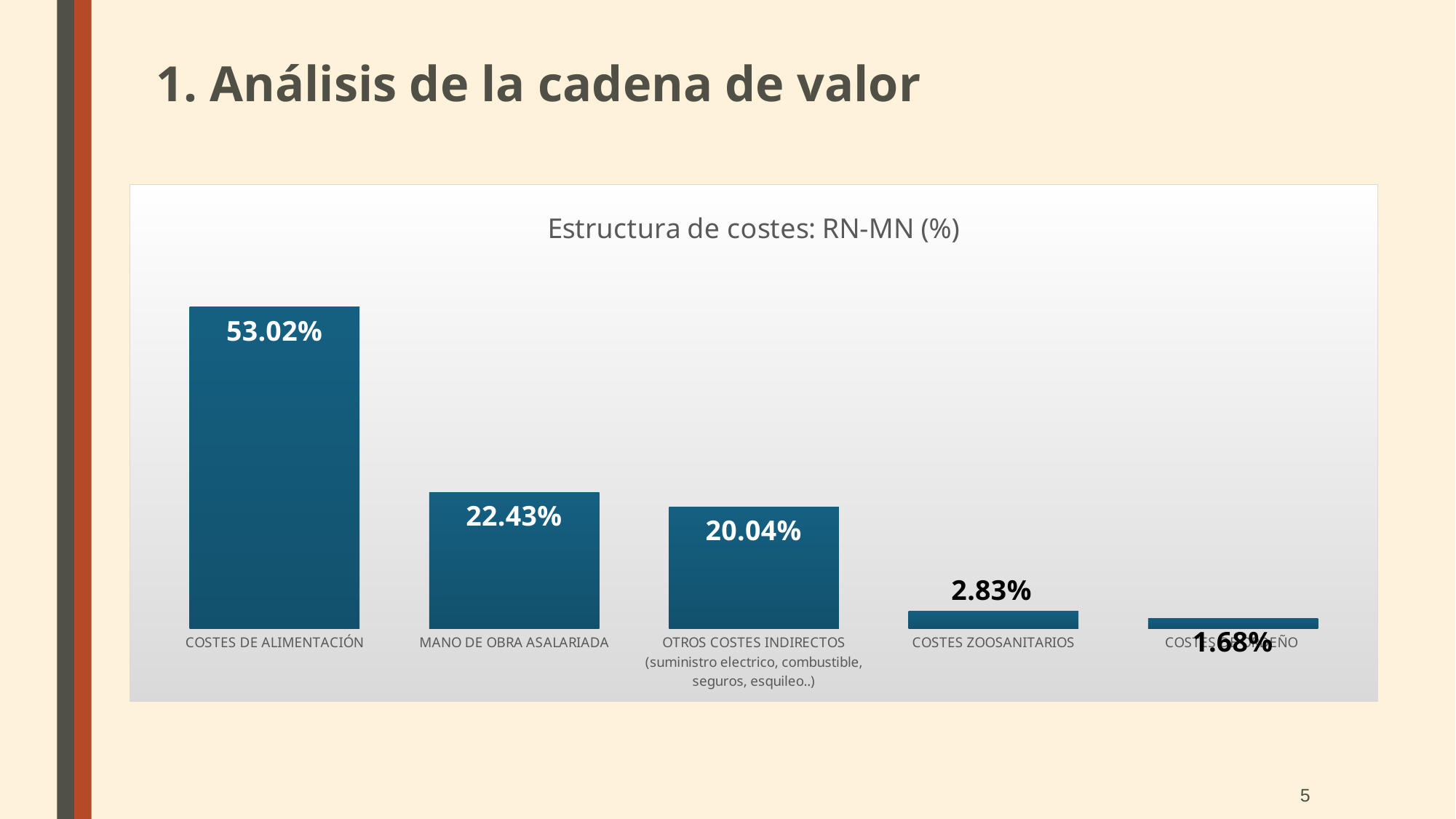
What is the value for COSTES DE ALIMENTACIÓN? 53.02% What is the difference between MANO DE OBRA ASALARIADA and OTROS COSTES INDIRECTOS? 2.39% What is the title of the chart? Estructura de costes: RN-MN (%) Which category has the highest value? COSTES DE ALIMENTACIÓN What type of chart is shown on the slide? Bar chart Which is larger, MANO DE OBRA ASALARIADA or OTROS COSTES INDIRECTOS? MANO DE OBRA ASALARIADA What is the value for COSTES ZOOSANITARIOS? 2.83% What is the value shown on the rightmost bar of the chart? 1.68% What is the value for MANO DE OBRA ASALARIADA? 22.43% What is the difference between COSTES DE ALIMENTACIÓN and MANO DE OBRA ASALARIADA? 30.59% How many bars are shown in the chart? 5 What is the value for OTROS COSTES INDIRECTOS? 20.04%